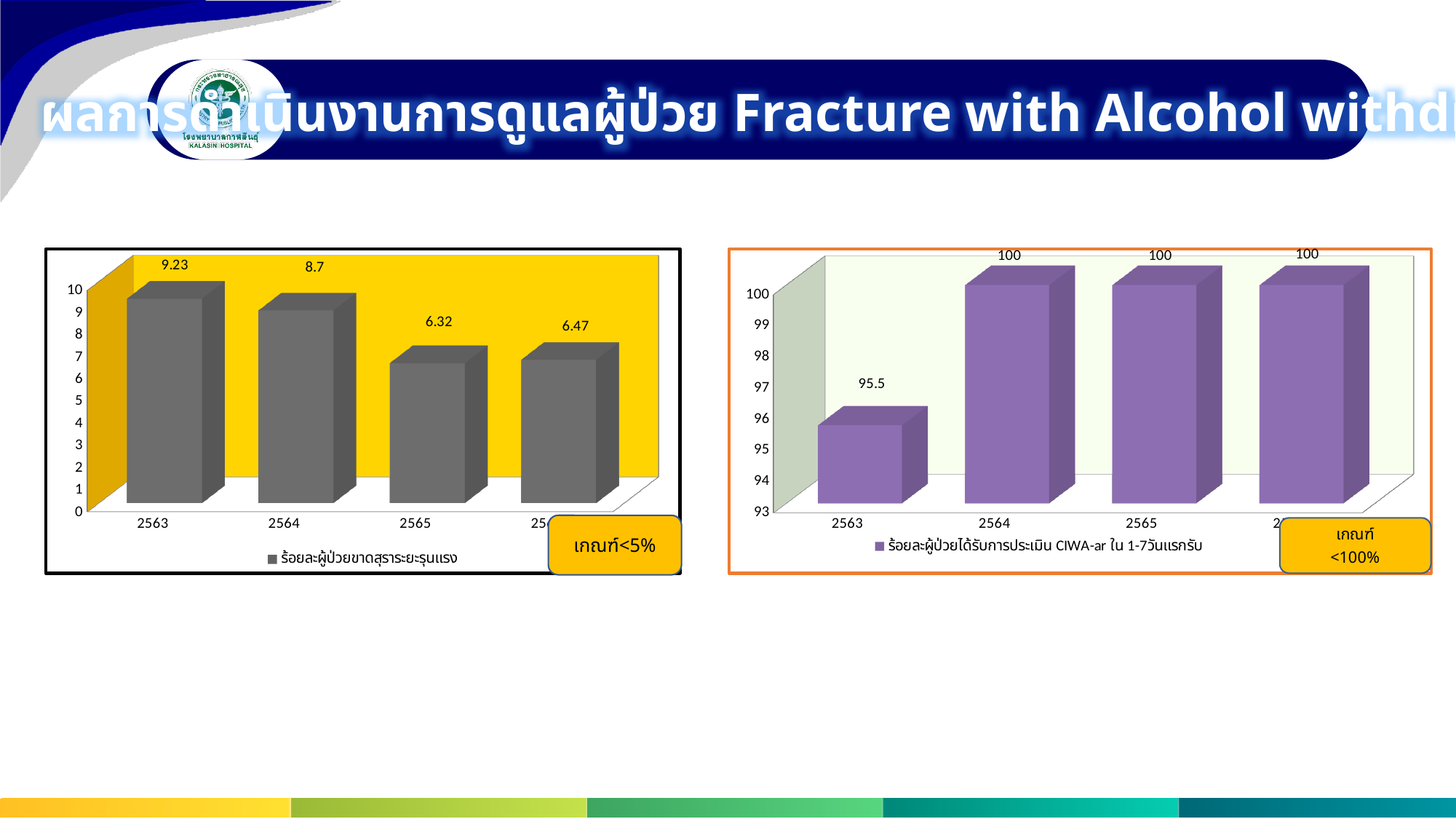
On the right chart, which year has the lowest value? 2563 On the left chart, which year has the highest value? 2563 On the left chart, which year has the lowest value? 2565 On the left chart, what is the value for 2565? 6.32 On the right chart, what is the value for 2564? 100 On the left chart, how many bars are plotted? 4 On the right chart, what is the difference between the values for 2564 and 2563? 4.5 On the left chart, what is the value for 2563? 9.23 What kind of chart is the right chart? Bar chart On the right chart, what is the value for 2563? 95.5 On the left chart, which is larger, the value for 2564 or the value for 2565? 2564 On the left chart, what is the difference between the values for 2563 and 2564? 0.53